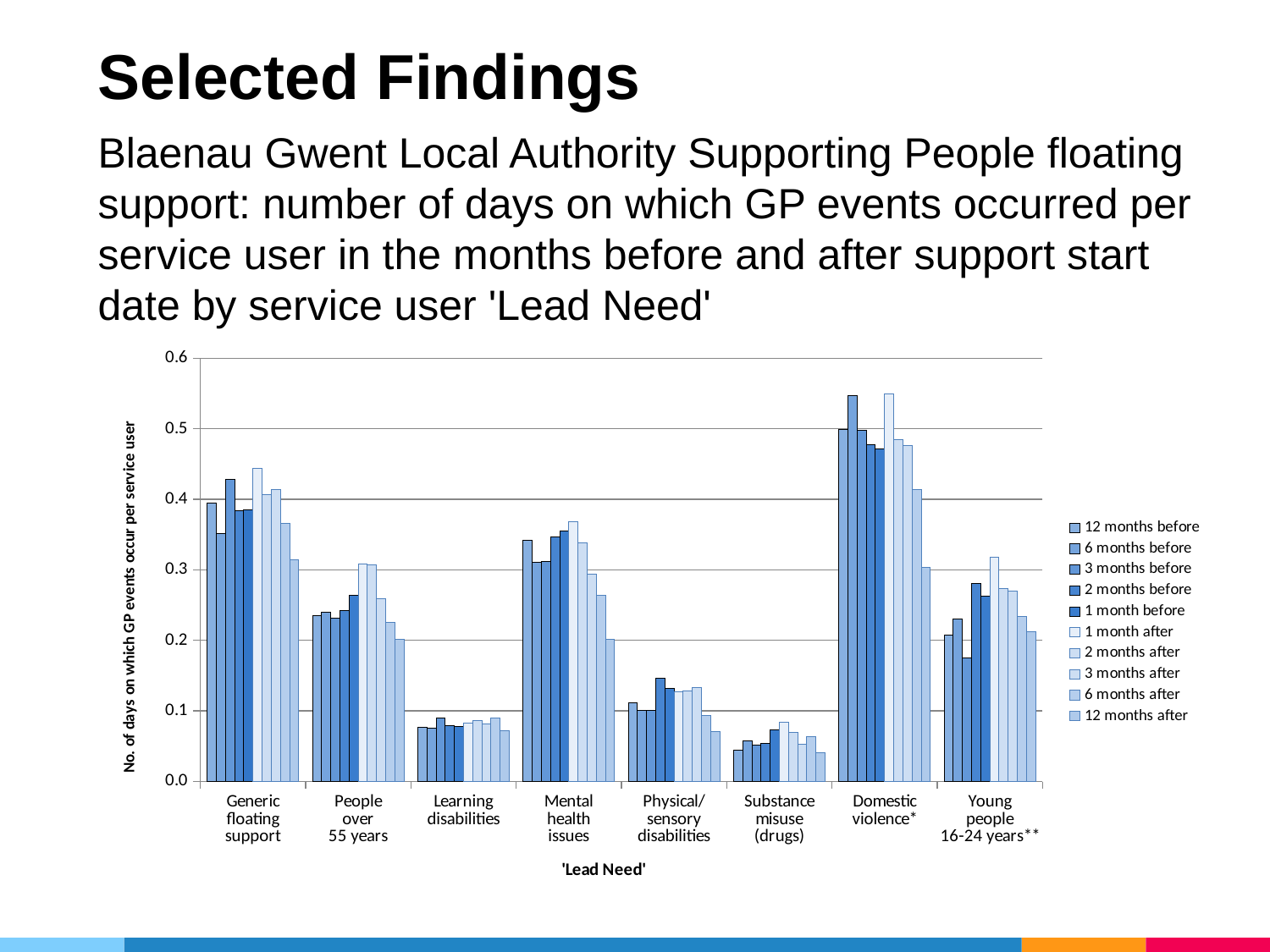
Which is larger at 1 month after: Domestic violence* or Young people 16-24 years**? Domestic violence* How many 'Lead Need' categories are shown on the x axis? 8 Which 'Lead Need' category has the lowest values overall? Substance misuse (drugs) What is the first entry in the legend? 12 months before What kind of chart is shown on the slide? bar chart Which 'Lead Need' category has the highest values overall? Domestic violence* Is the value for Mental health issues at 12 months before greater or less than 0.3? greater Is the value for Learning disabilities at 12 months before greater or less than 0.1? less Is the value for Domestic violence* at 1 month after greater or less than 0.5? greater How many series does the legend list? 10 What is the title of the y axis? No. of days on which GP events occur per service user